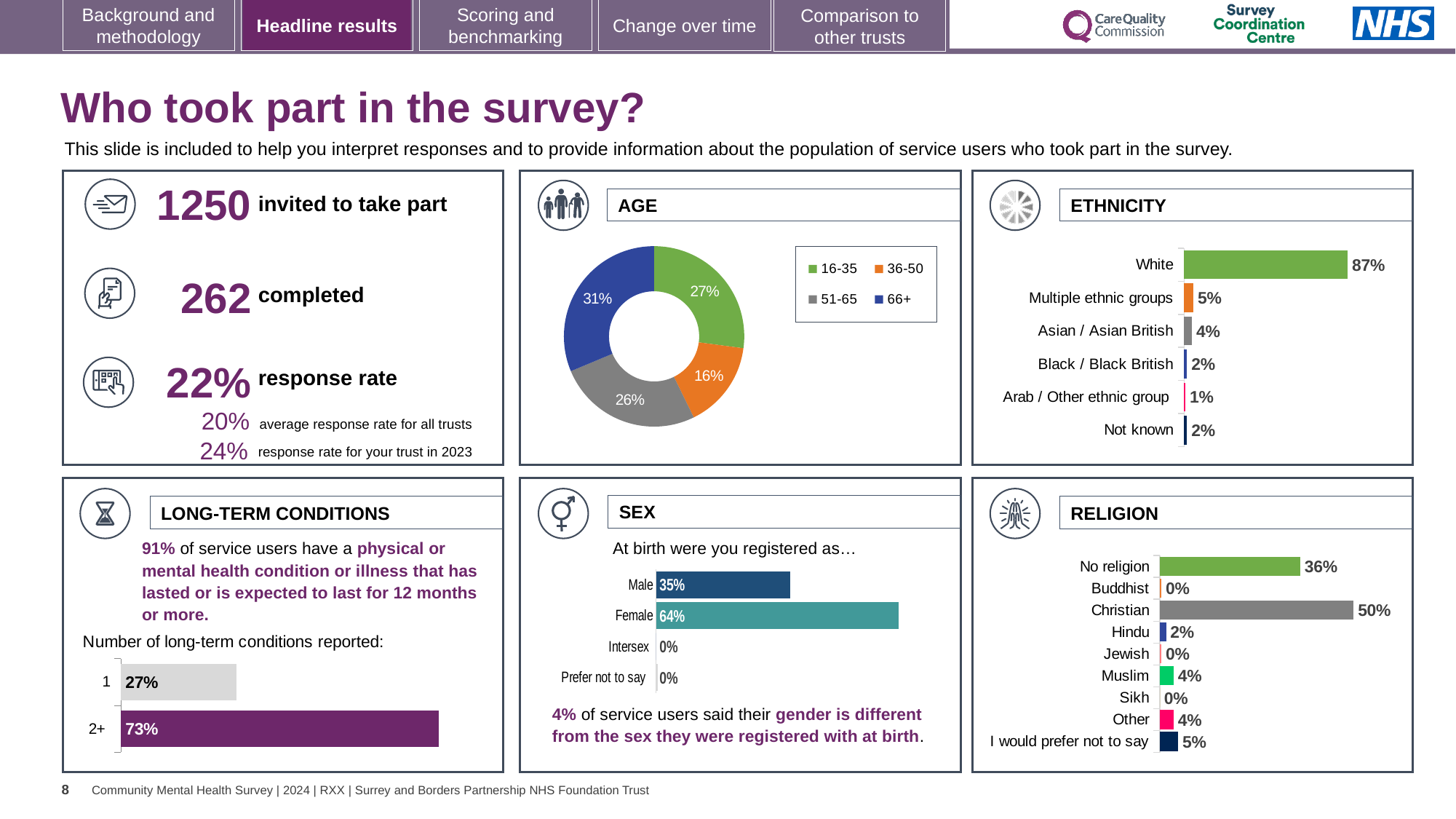
In the LONG-TERM CONDITIONS chart, what percentage reported 2+ long-term conditions? 73% In the RELIGION chart, what is the difference between Christian and No religion? 14% In the SEX chart, which is larger, Male or Female? Female What kind of chart is the AGE chart? Donut (pie) chart In the ETHNICITY chart, which category has the highest value? White In the ETHNICITY chart, what is the value for Multiple ethnic groups? 5% How many categories are shown in the SEX chart? 4 In the ETHNICITY chart, what is the difference between White and Asian / Asian British? 83% In the RELIGION chart, which category has the highest value? Christian In the AGE chart, which age group has the smallest share? 36-50 How many age groups does the legend of the AGE chart list? 4 In the AGE chart, what percentage of respondents were aged 66+? 31%